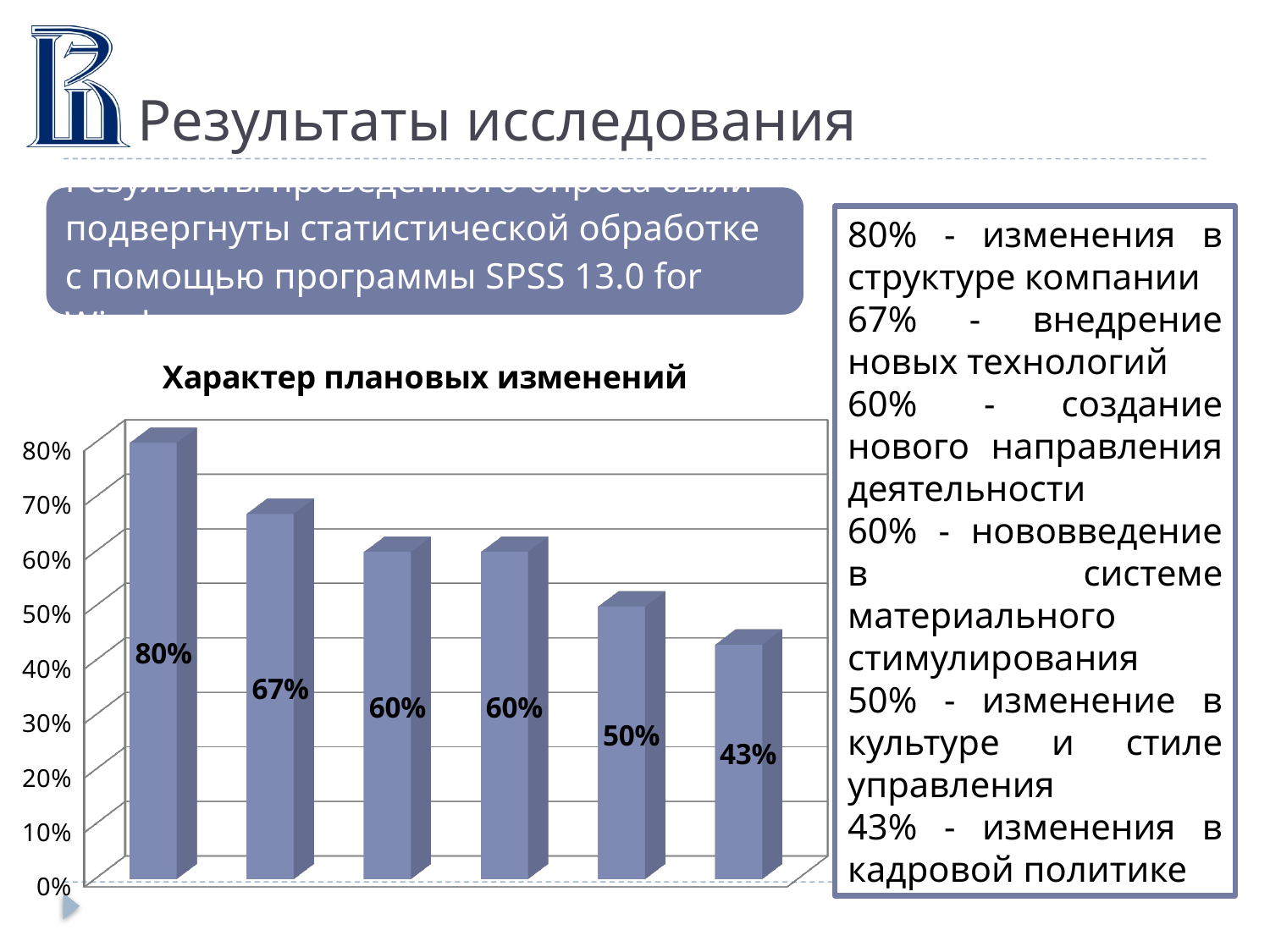
What is the title of the chart? Характер плановых изменений What is the difference between the first bar (80%) and the last bar (43%)? 37% How many bars in the chart have a value of exactly 60%? 2 What is the difference between the second bar (67%) and the fifth bar (50%)? 17% How many bars are plotted in the chart? 6 What is the value of the tallest bar in the chart? 80% What is the value of the second bar from the left? 67% What kind of chart is shown on the slide? bar chart Which is larger, the second bar or the third bar? the second bar (67%) Do the bar values rise or fall from left to right across the chart? fall What is the value of the fifth bar from the left? 50% What is the value of the shortest bar in the chart? 43%